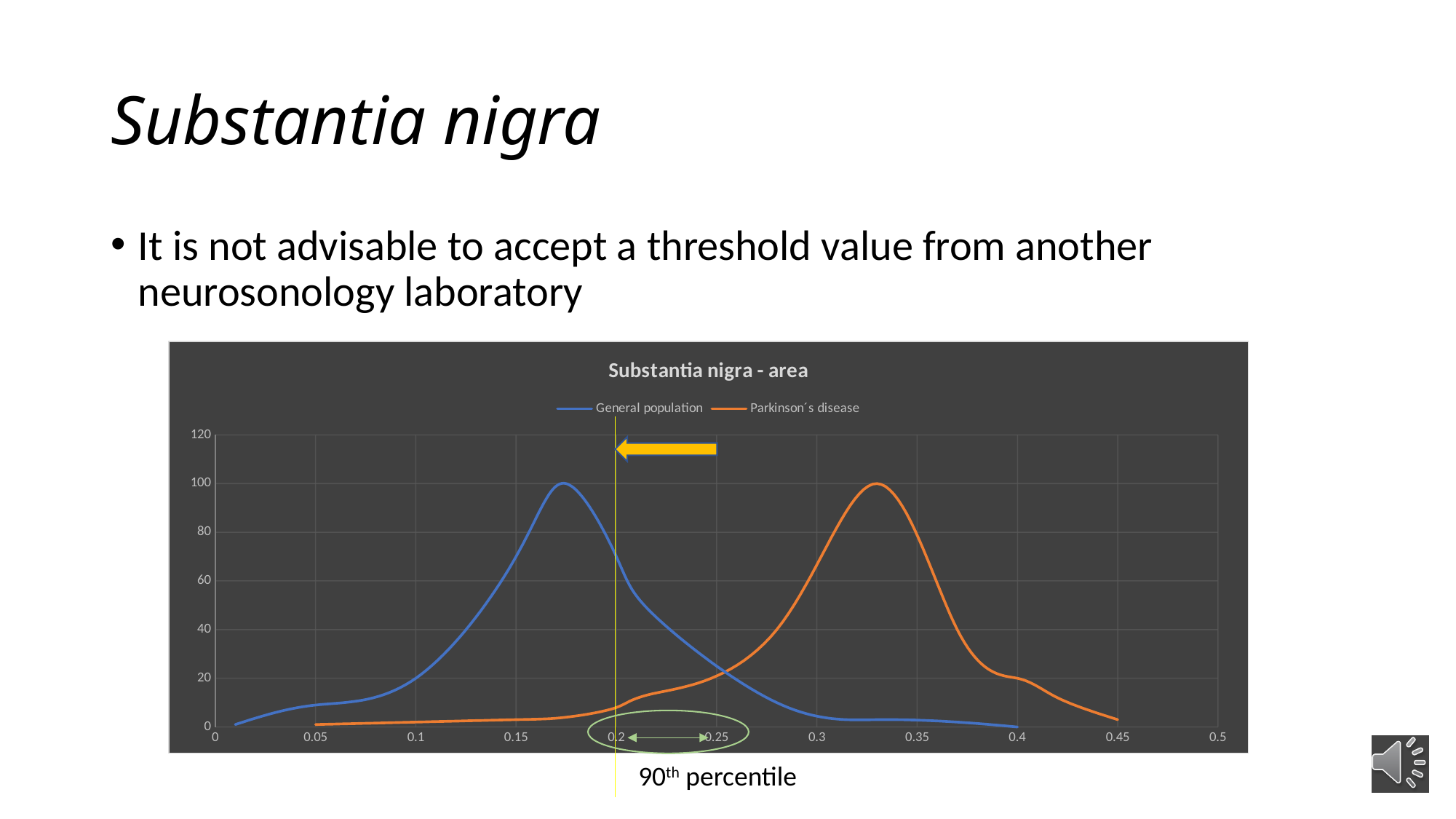
At 0.15 on the x axis, which series has the higher value, General population or Parkinson´s disease? General population Is the value of the General population series at 0.15 greater or less than 40? greater What is the title of the chart? Substantia nigra - area What label is written below the vertical line at about 0.2 on the x axis? 90th percentile Which series reaches its peak at a larger x-axis value? Parkinson´s disease How many series does the legend of the chart list? 2 Is the value of the Parkinson´s disease series at 0.15 greater or less than 20? less At 0.3 on the x axis, which series has the higher value, General population or Parkinson´s disease? Parkinson´s disease Is the value of the General population series at 0.3 greater or less than 20? less What kind of chart is shown on the slide? line chart Does the General population series rise or fall between 0.2 and 0.4 on the x axis? fall